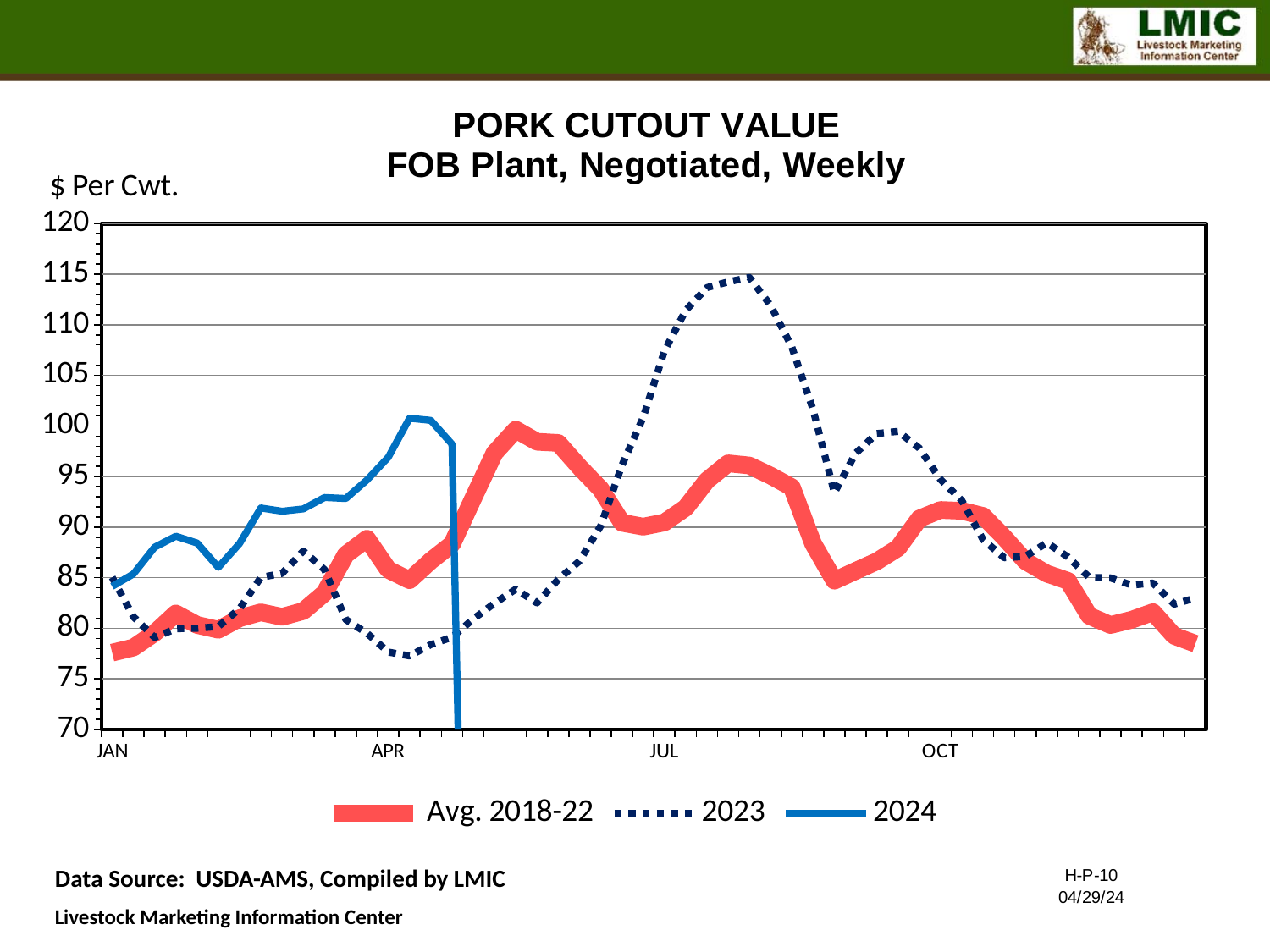
Is the value of the 2024 line at JAN greater or less than 90? less How many series does the legend list? 3 Does the 2024 line rise or fall from JAN to APR? rise Is the highest value reached by the 2023 line greater or less than 110? greater Is the highest value reached by the 2024 line greater or less than 95? greater At APR, which line is higher, 2024 or 2023? 2024 What kind of chart is shown on the slide? line chart How many month labels are shown on the x axis? 4 What is the title of the chart? PORK CUTOUT VALUE FOB Plant, Negotiated, Weekly Which series reaches the highest value anywhere on the chart? 2023 What are the three series named in the legend? Avg. 2018-22, 2023, 2024